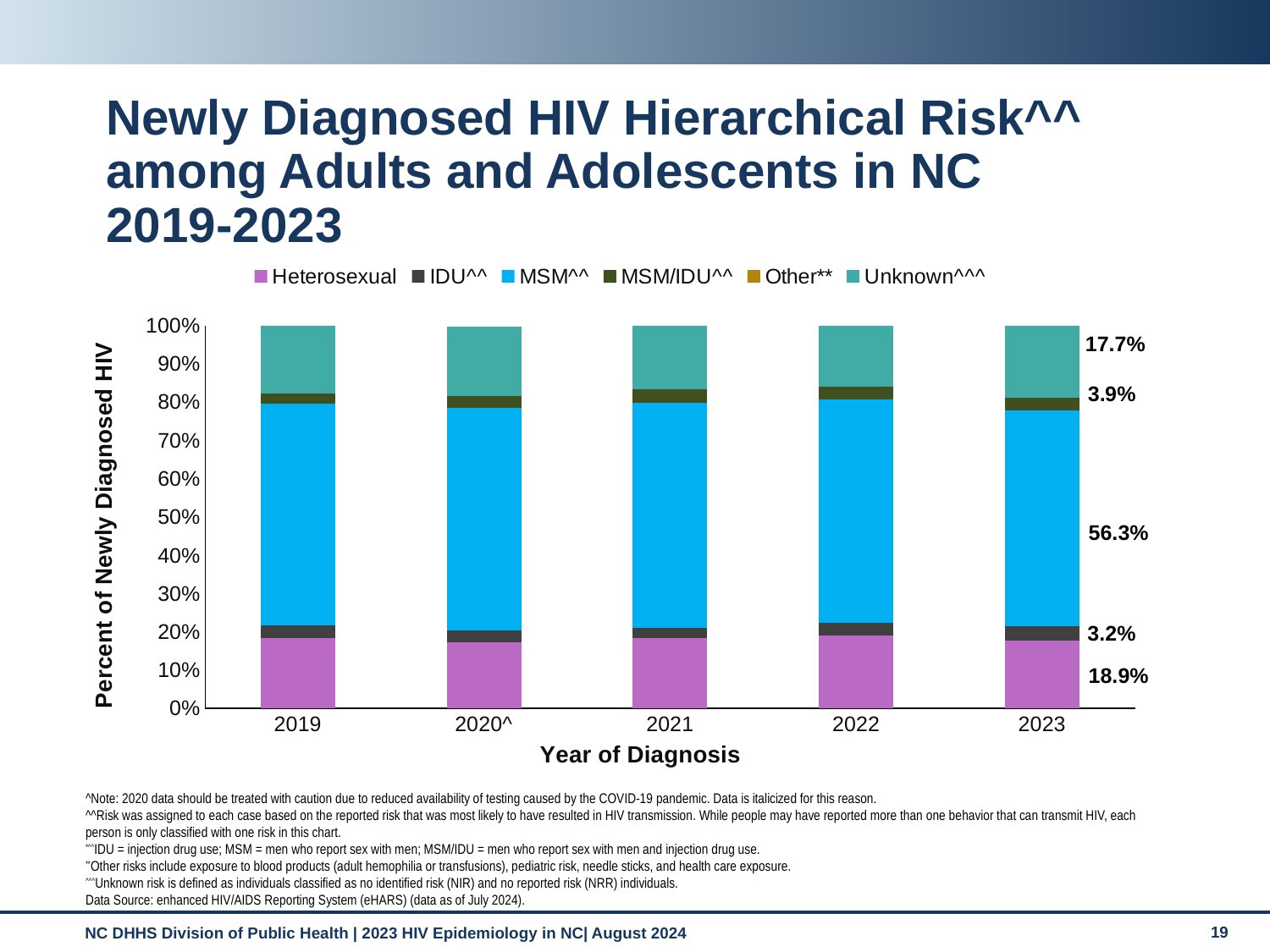
How many risk categories does the legend list? 6 In 2023, how many percentage points higher is the MSM^^ share than the Heterosexual share? 38.6% What is the title of the x axis? Year of Diagnosis What percentage of newly diagnosed HIV cases in 2023 had Unknown^^^ risk? 18.9% Which risk category accounts for the largest share of newly diagnosed HIV cases in 2023? MSM^^ How many years of diagnosis are shown on the x axis? 5 What percentage of newly diagnosed HIV cases in 2023 were attributed to MSM^^? 56.3% What percentage of newly diagnosed HIV cases in 2023 were attributed to Heterosexual risk? 17.7% What kind of chart is shown on the slide? Stacked bar chart What percentage of newly diagnosed HIV cases in 2023 were attributed to IDU^^? 3.9% In 2023, which is larger: the Heterosexual share or the Unknown^^^ share? Unknown^^^ What percentage of newly diagnosed HIV cases in 2023 were attributed to MSM/IDU^^? 3.2%